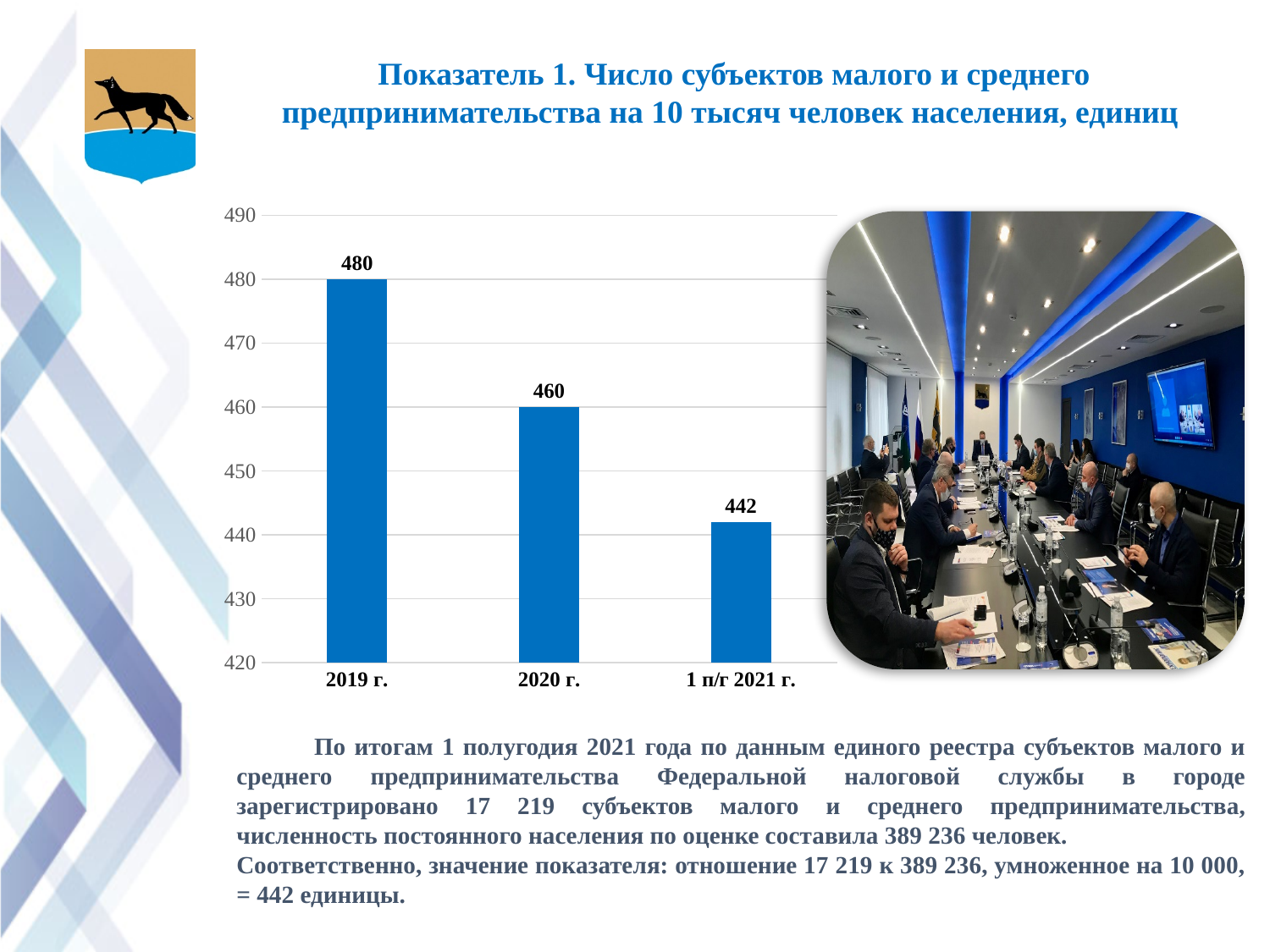
Which category has the lowest value? 1 п/г 2021 г. What is the value for 2020 г.? 460 What is the value for 1 п/г 2021 г.? 442 What is the value for 2019 г.? 480 Do the values rise or fall from 2019 г. to 1 п/г 2021 г.? fall What is the difference between the values for 2019 г. and 2020 г.? 20 Is the value for 2020 г. greater or less than 450? greater Which is larger, the value for 2019 г. or the value for 1 п/г 2021 г.? 2019 г. What kind of chart is shown on the slide? bar chart How many categories are shown on the x axis? 3 What is the difference between the values for 2020 г. and 1 п/г 2021 г.? 18 Which category has the highest value? 2019 г.